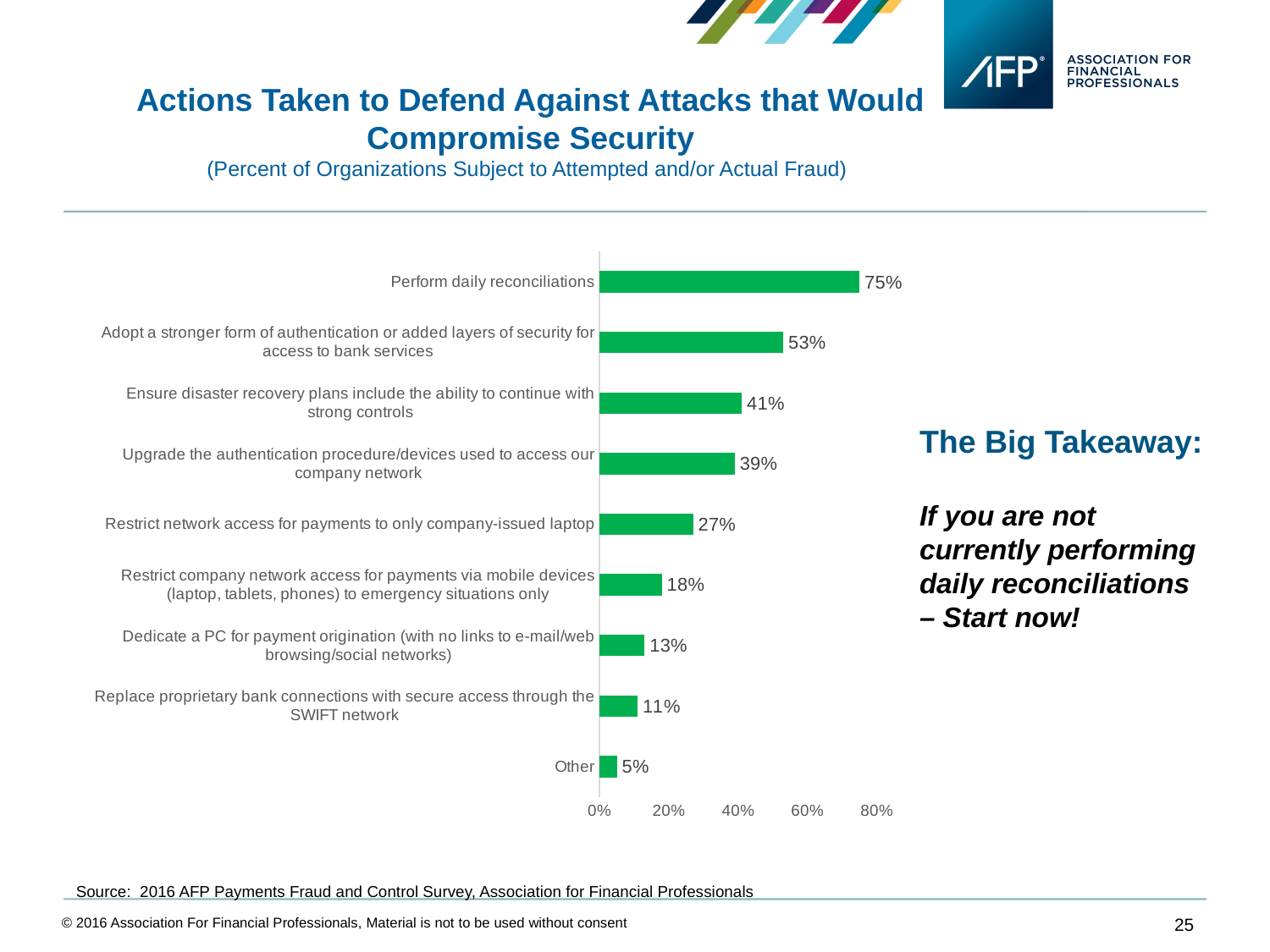
What kind of chart is shown on the slide? Bar chart Is the value for "Dedicate a PC for payment origination (with no links to e-mail/web browsing/social networks)" greater or less than 20%? less What is the title of the chart? Actions Taken to Defend Against Attacks that Would Compromise Security What percentage of organizations perform daily reconciliations? 75% What is the value for "Restrict network access for payments to only company-issued laptop"? 27% What is the difference between "Perform daily reconciliations" and "Adopt a stronger form of authentication or added layers of security for access to bank services"? 22% Which action has the highest percentage? Perform daily reconciliations Which category has the lowest percentage? Other How many categories are shown in the chart? 9 Which is larger: the value for "Ensure disaster recovery plans include the ability to continue with strong controls" or "Upgrade the authentication procedure/devices used to access our company network"? Ensure disaster recovery plans include the ability to continue with strong controls What is the difference between the values for "Restrict company network access for payments via mobile devices (laptop, tablets, phones) to emergency situations only" and "Other"? 13% What percentage of organizations replace proprietary bank connections with secure access through the SWIFT network? 11%